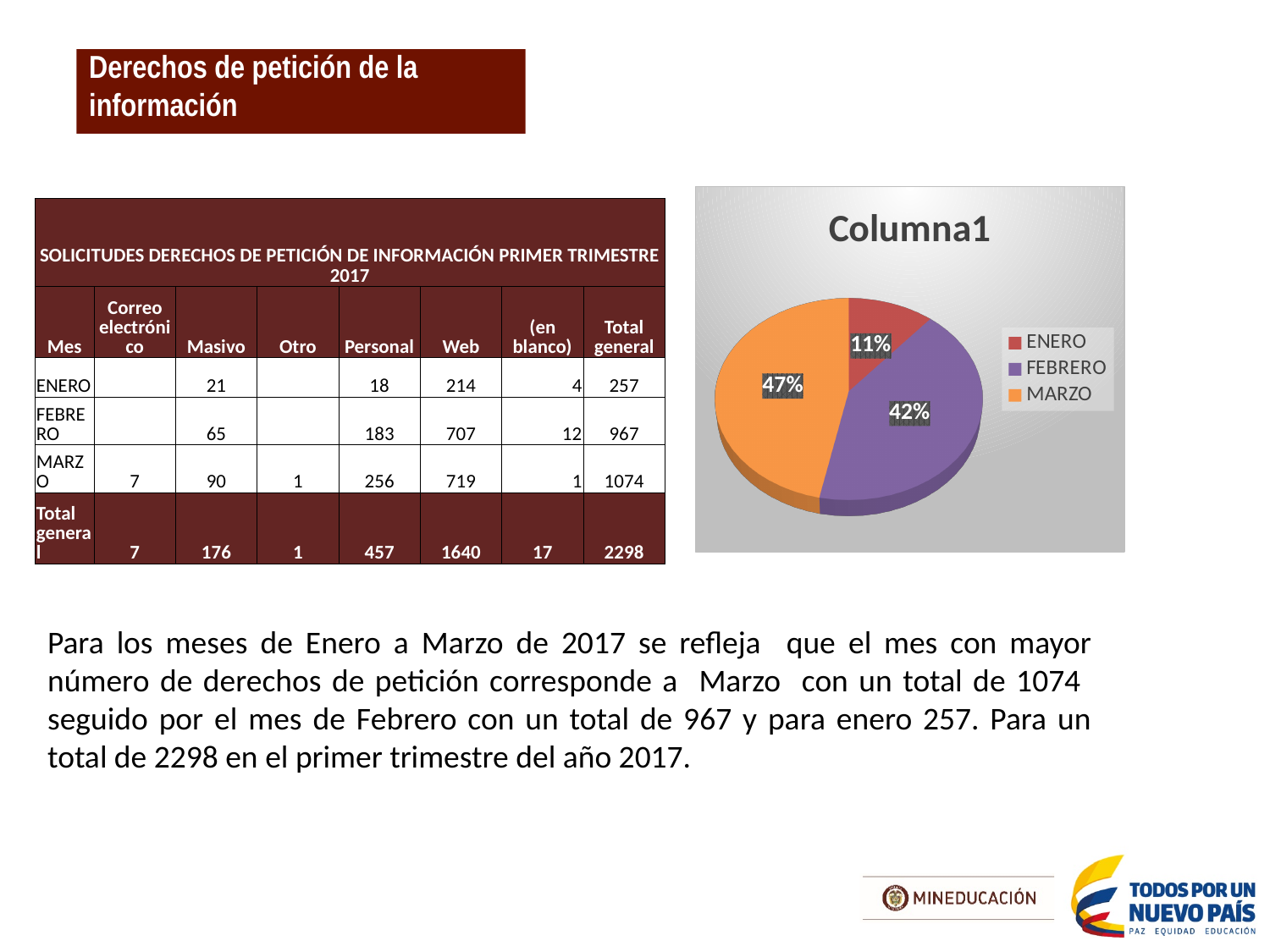
What is the title of the pie chart? Columna1 Which slice is larger in the pie chart, FEBRERO or ENERO? FEBRERO Which month has the smallest slice in the pie chart? ENERO What kind of chart is shown on the slide? pie chart What share of the pie does ENERO represent? 11% What share of the pie does MARZO represent? 47% What colour is the MARZO slice in the pie chart? orange What share of the pie does FEBRERO represent? 42% Which month has the largest slice in the pie chart? MARZO How many entries does the pie chart's legend list? 3 What is the difference in percentage points between the MARZO and ENERO slices? 36 How many slices does the pie chart have? 3